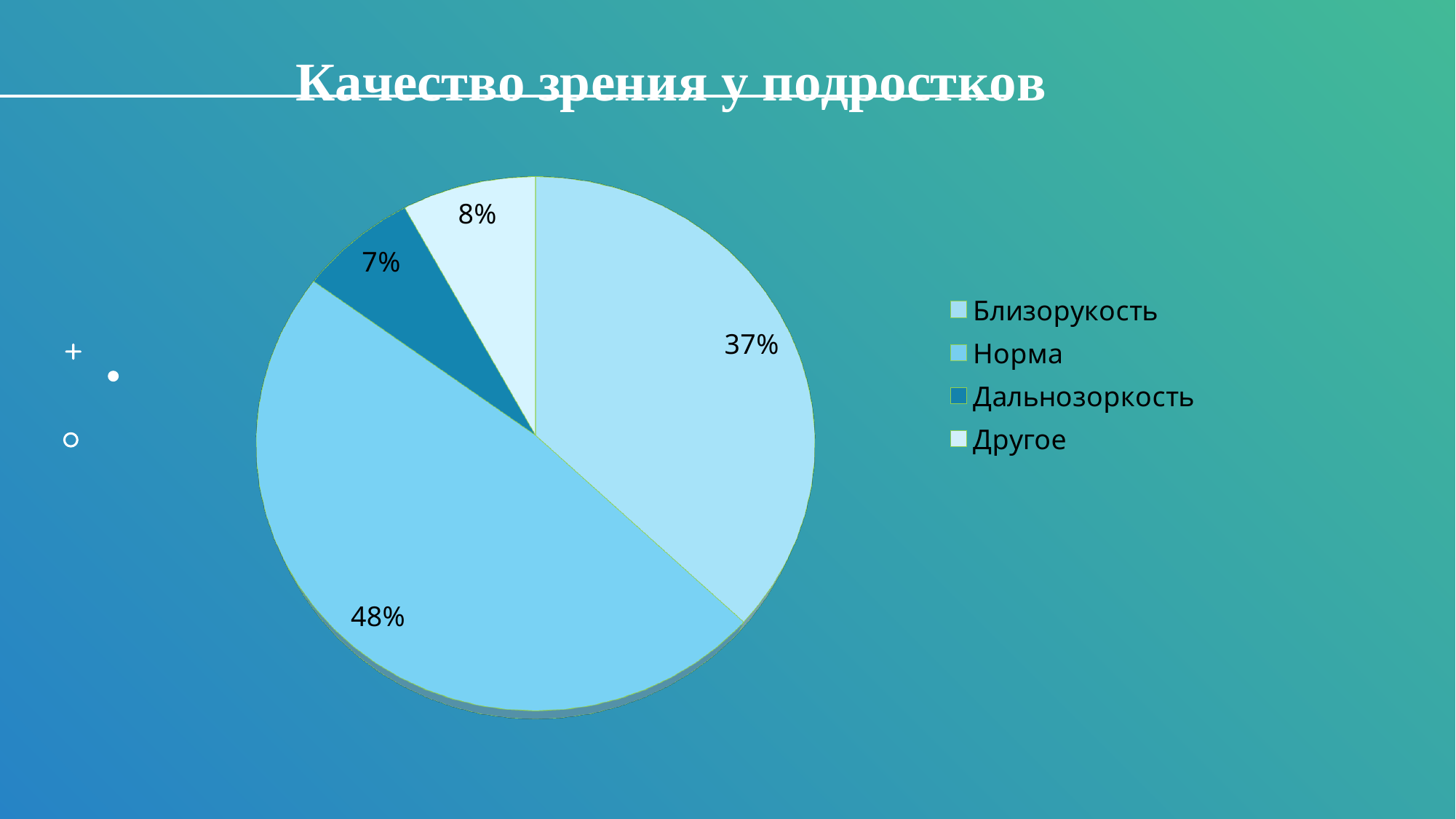
What is the difference between the shares of Норма and Близорукость? 11% What share of the pie does Другое take? 8% Which category has the largest slice of the pie? Норма What share of the pie does Дальнозоркость take? 7% What kind of chart is shown on the slide? Pie chart Which legend entry is listed first? Близорукость How many categories does the pie chart show? 4 Which is larger, the share of Близорукость or the share of Норма? Норма Which category has the smallest slice of the pie? Дальнозоркость What share of the pie does Норма take? 48% What is the title of the slide's chart? Качество зрения у подростков